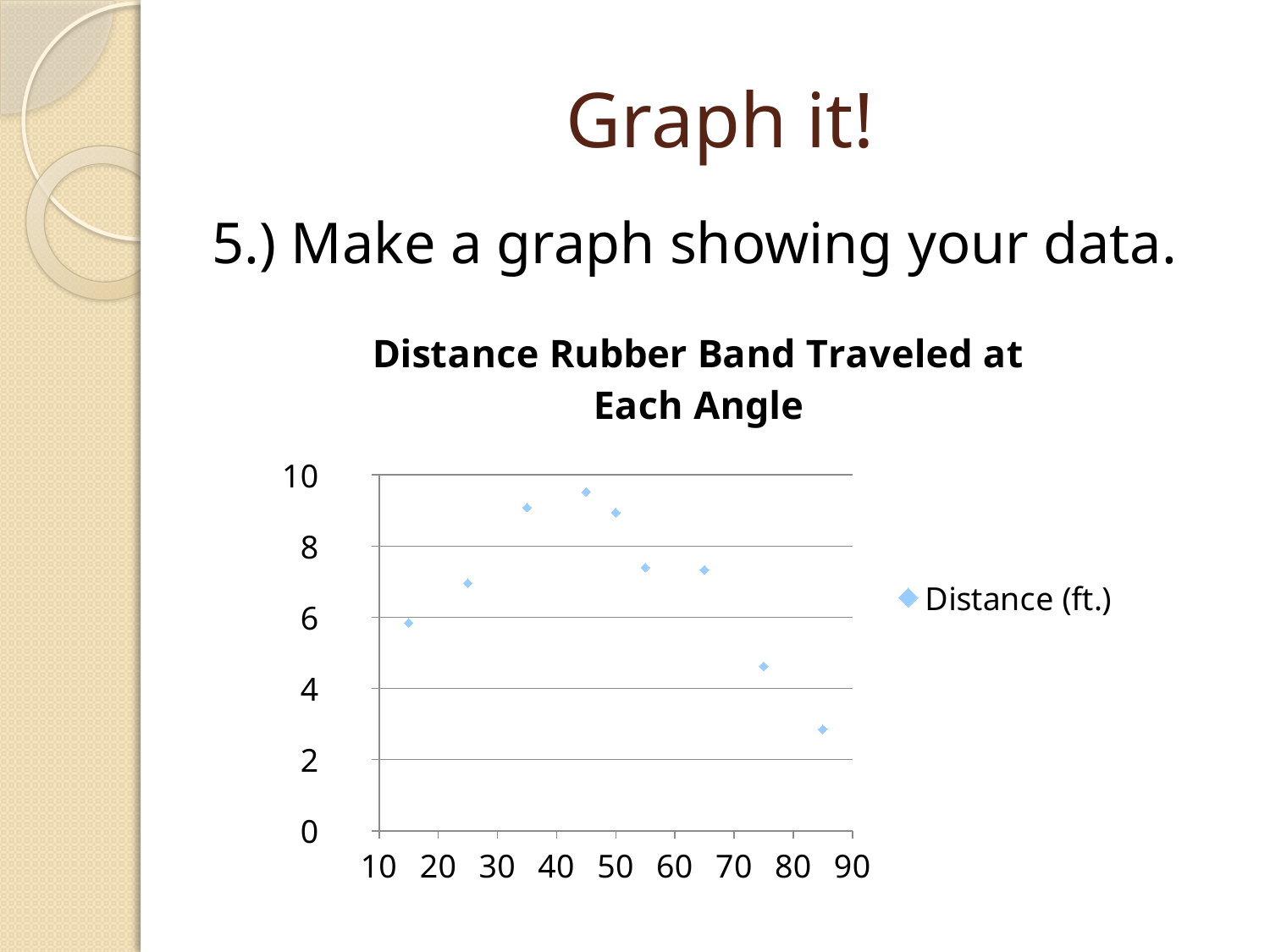
What is the name of the series shown in the legend? Distance (ft.) Do the values rise or fall as the x axis moves from 10 to 45? rise Is the value of the highest point on the chart greater or less than 8? greater Is the value of the rightmost point (near 85 on the x axis) greater or less than 4? less What kind of chart is shown on the slide? scatter chart Do the values rise or fall as the x axis moves from 50 to 90? fall How many data points are plotted on the chart? 9 Which has the larger value: the leftmost point or the rightmost point? the leftmost point Is the value of the leftmost point (near 15 on the x axis) greater or less than 4? greater How many series does the legend list? 1 What is the title of the chart? Distance Rubber Band Traveled at Each Angle